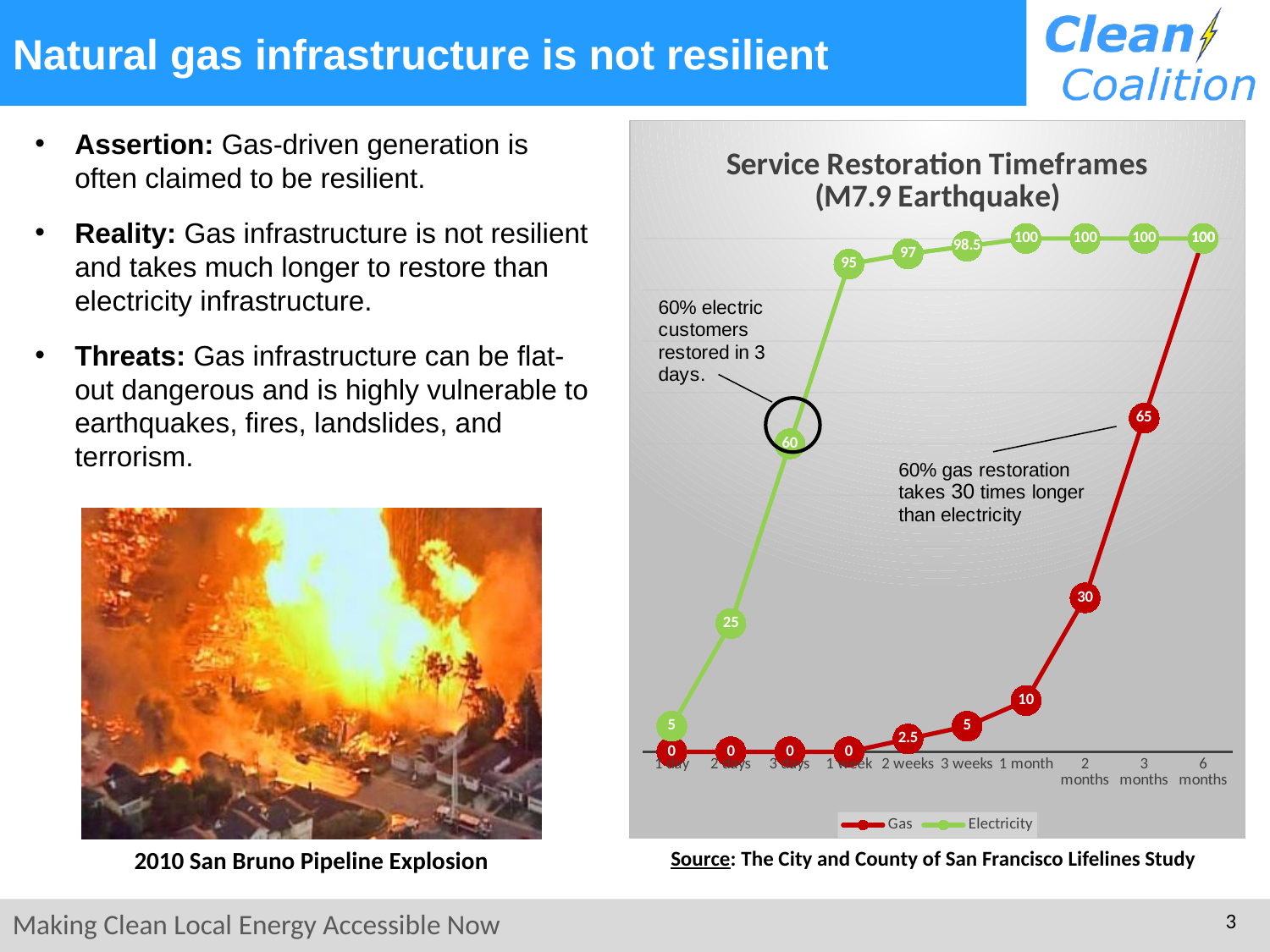
How many time categories are shown on the x axis of the chart? 10 What is the Gas value at 3 months? 65 Does the Gas series rise or fall along the x axis from 1 day to 6 months? Rise What is the Electricity value at 3 weeks? 98.5 How many series does the chart legend list? 2 What is the Gas value at 2 weeks? 2.5 What type of chart is shown on the slide? Line chart What is the title of the chart? Service Restoration Timeframes (M7.9 Earthquake) What is the Electricity value at 3 days? 60 At which x-axis category does the Gas series first reach 100? 6 months What is the difference between the Electricity and Gas values at 1 week? 95 Which series has the higher value at 2 months, Gas or Electricity? Electricity